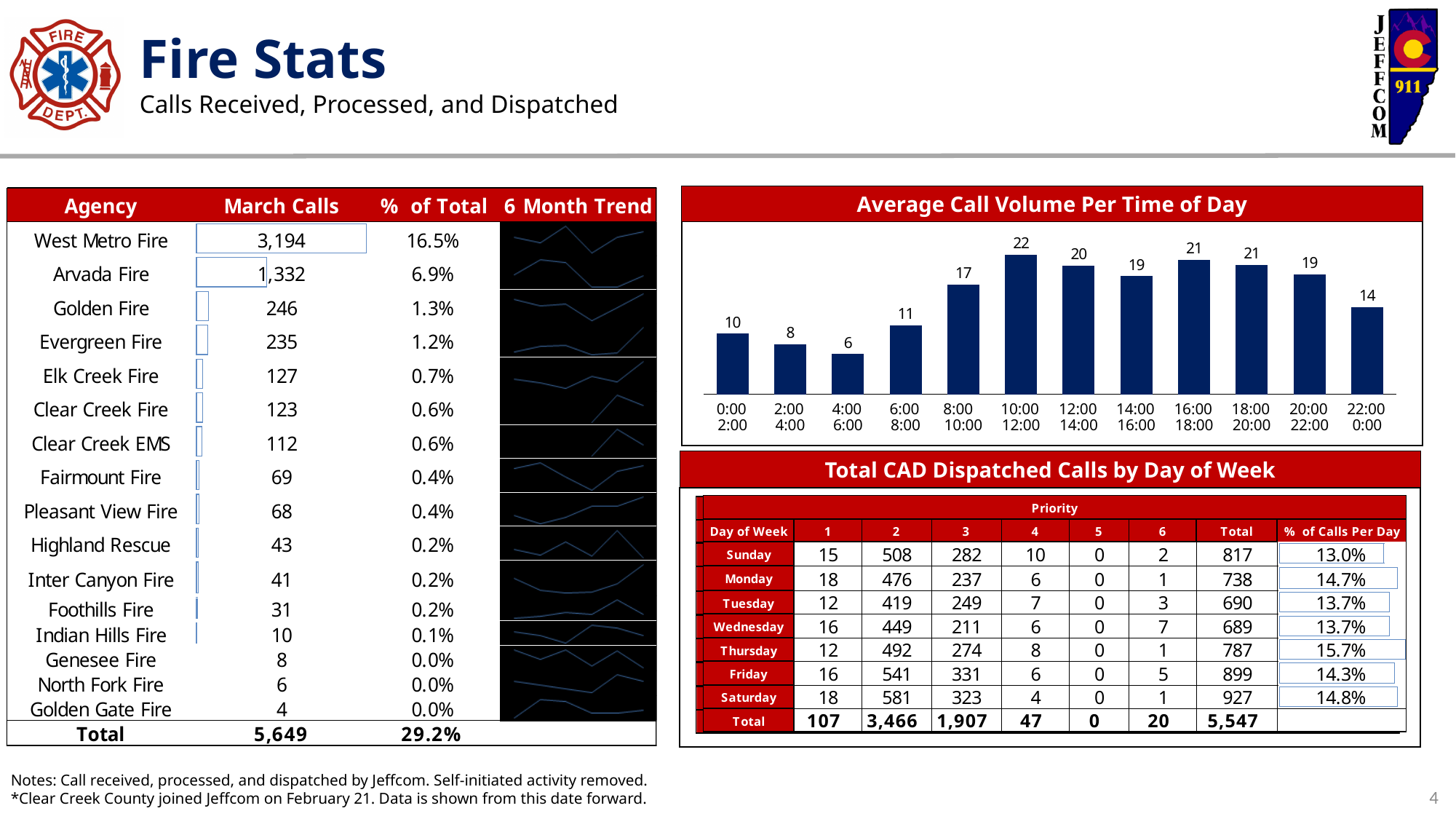
In the 'Average Call Volume Per Time of Day' chart, what is the value for the 4:00–6:00 time slot? 6 In the 'Average Call Volume Per Time of Day' chart, do the values rise or fall from 4:00–6:00 to 10:00–12:00? Rise In the 'Average Call Volume Per Time of Day' chart, which time slot has the lowest average call volume? 4:00–6:00 How many time-of-day bars are shown in the 'Average Call Volume Per Time of Day' chart? 12 In the 'Average Call Volume Per Time of Day' chart, what is the difference between the 10:00–12:00 value and the 4:00–6:00 value? 16 In the 'Average Call Volume Per Time of Day' chart, what is the difference between the 8:00–10:00 value and the 6:00–8:00 value? 6 In the 'Average Call Volume Per Time of Day' chart, which is larger: the value for 12:00–14:00 or the value for 22:00–0:00? 12:00–14:00 In the 'Average Call Volume Per Time of Day' chart, which is larger: the value for 0:00–2:00 or the value for 2:00–4:00? 0:00–2:00 In the 'Average Call Volume Per Time of Day' chart, what is the value for the 22:00–0:00 time slot? 14 In the 'Average Call Volume Per Time of Day' chart, what is the value for the 10:00–12:00 time slot? 22 In the 'Average Call Volume Per Time of Day' chart, which time slot has the highest average call volume? 10:00–12:00 What type of chart is 'Average Call Volume Per Time of Day'? Bar chart